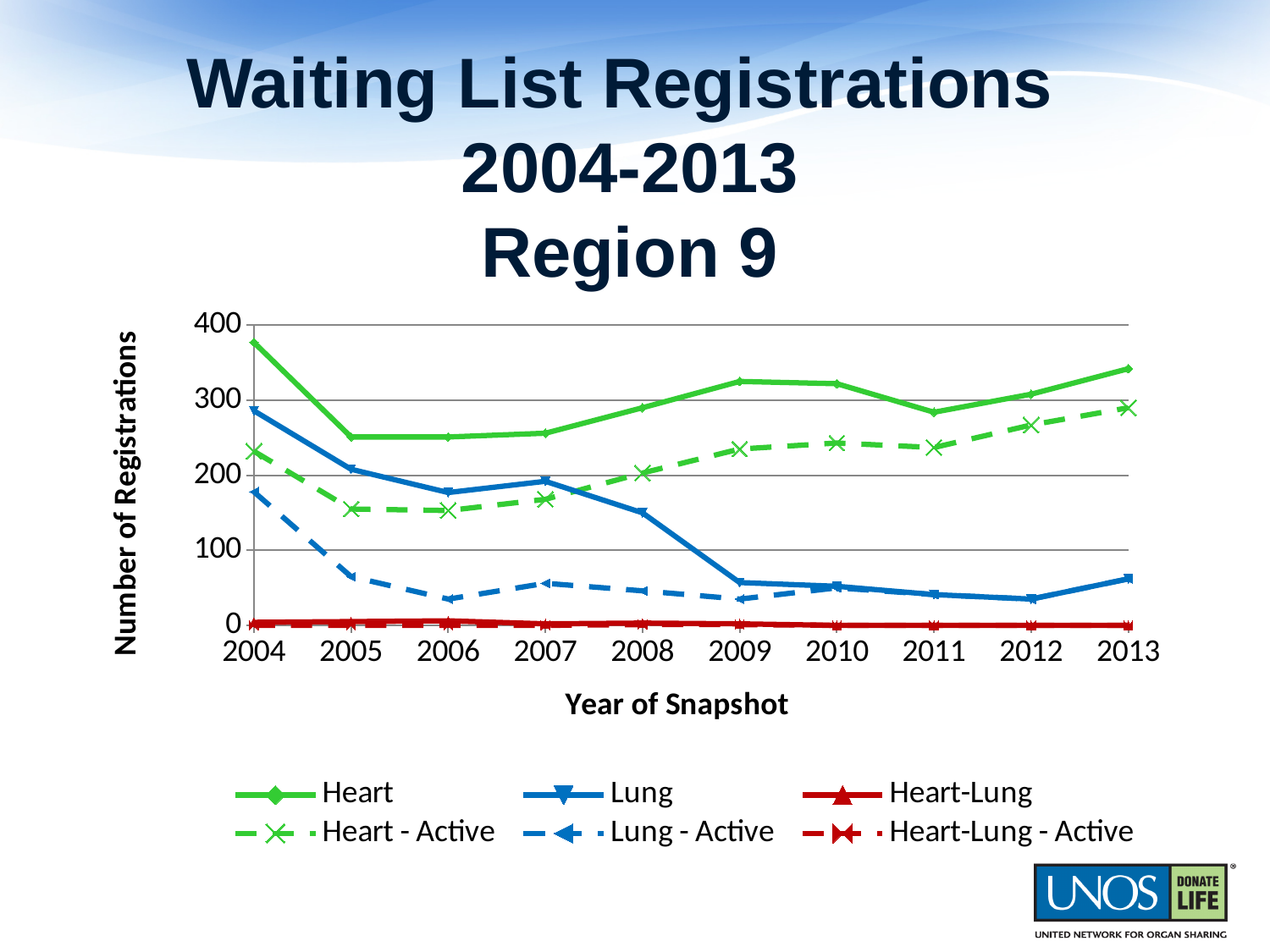
Is the value for Heart - Active in 2013 greater or less than 200? greater How many years are plotted along the x axis? 10 Is the value for Lung in 2009 greater or less than 100? less Which is larger in 2010, Heart or Lung? Heart What kind of chart is shown on the slide? line chart How many series does the legend list? 6 Does the Lung series generally rise or fall from 2004 to 2012? fall Is the value for Heart in 2005 greater or less than 300? less What is the label of the y axis? Number of Registrations In which year is the Heart series at its highest? 2004